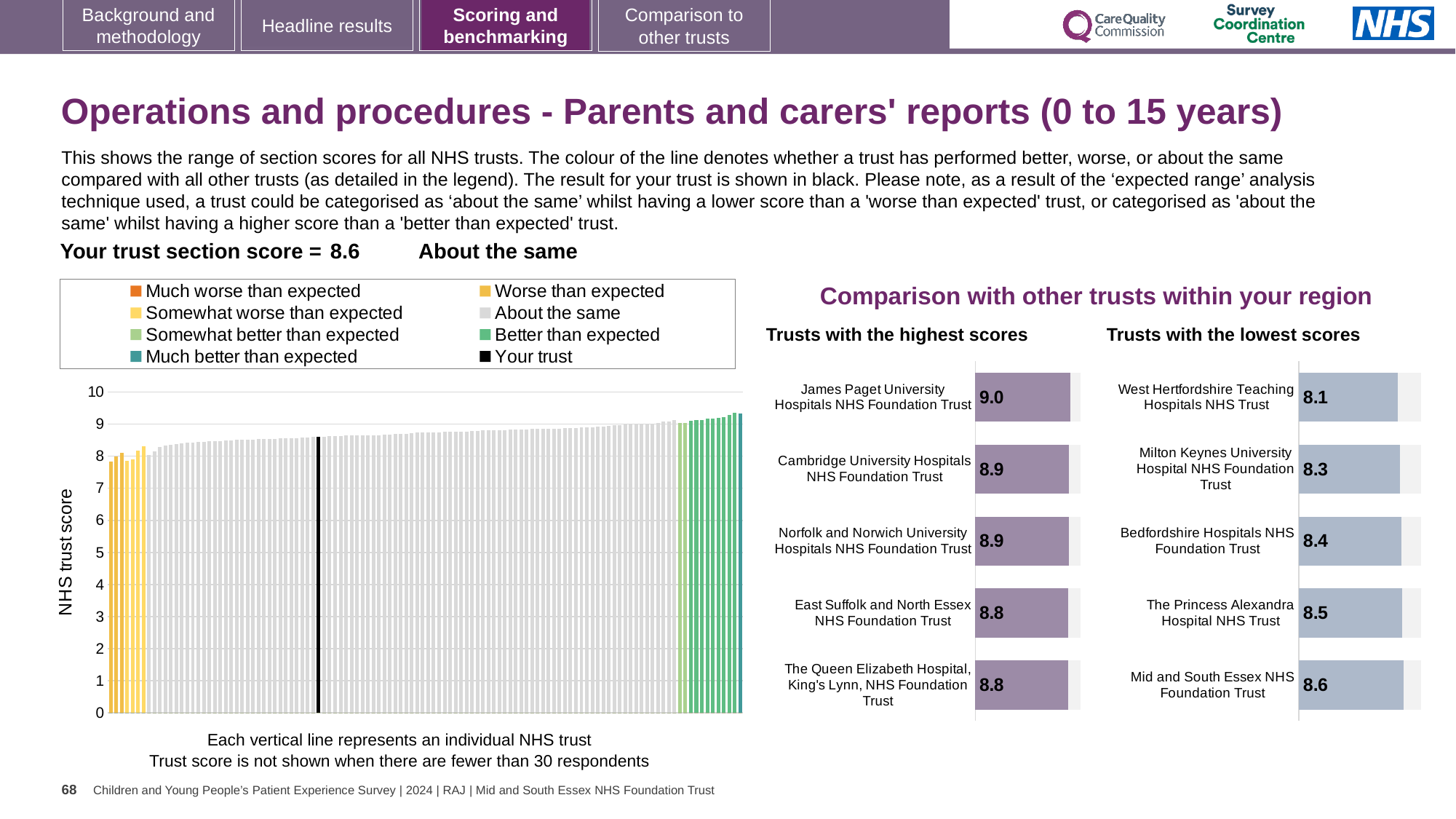
In the 'Trusts with the lowest scores' chart, which trust has the lowest score? West Hertfordshire Teaching Hospitals NHS Trust What is the difference between the score for James Paget University Hospitals NHS Foundation Trust in the highest scores chart and the score for West Hertfordshire Teaching Hospitals NHS Trust in the lowest scores chart? 0.9 In the NHS trust score chart on the left, is the value for the black 'Your trust' bar greater or less than 8? greater In the 'Trusts with the highest scores' chart, which trust has the highest score? James Paget University Hospitals NHS Foundation Trust In the 'Trusts with the lowest scores' chart, what is the score for Mid and South Essex NHS Foundation Trust? 8.6 In the 'Trusts with the lowest scores' chart, what is the score for West Hertfordshire Teaching Hospitals NHS Trust? 8.1 In the NHS trust score chart on the left, do the bar values rise or fall from left to right along the x axis? rise How many entries does the legend above the NHS trust score chart list? 8 In the 'Trusts with the highest scores' chart, what is the score for James Paget University Hospitals NHS Foundation Trust? 9.0 What kind of chart is the NHS trust score chart on the left of the slide? bar chart How many trusts are shown in the 'Trusts with the highest scores' chart? 5 In the 'Trusts with the lowest scores' chart, which has the larger score: Milton Keynes University Hospital NHS Foundation Trust or The Princess Alexandra Hospital NHS Trust? The Princess Alexandra Hospital NHS Trust